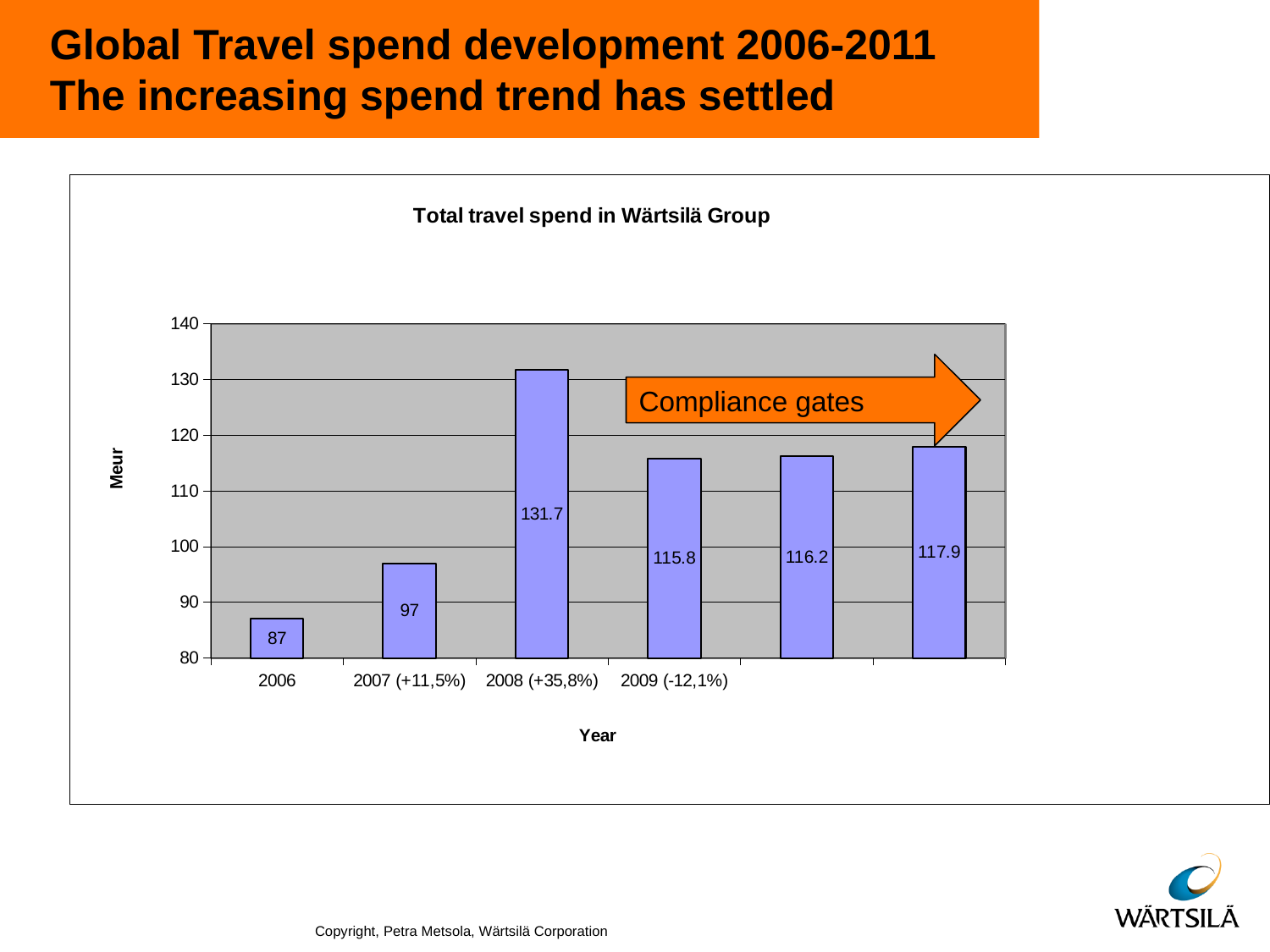
What is the travel spend value for 2008 (+35,8%)? 131.7 What is the value for 2009 (-12,1%)? 115.8 Which year has the lowest total travel spend? 2006 What value is shown for the 2007 (+11,5%) bar? 97 What is the total travel spend for 2006? 87 What is the difference between the 2008 value and the 2009 value? 15.9 Which year has the highest total travel spend? 2008 (+35,8%) How many bars are plotted in the chart? 6 What type of chart is shown on the slide? Bar chart Which is larger, the value for 2007 or the value for 2009? 2009 By how much did travel spend increase from 2006 to 2007? 10 What is the label on the vertical axis of the chart? Meur